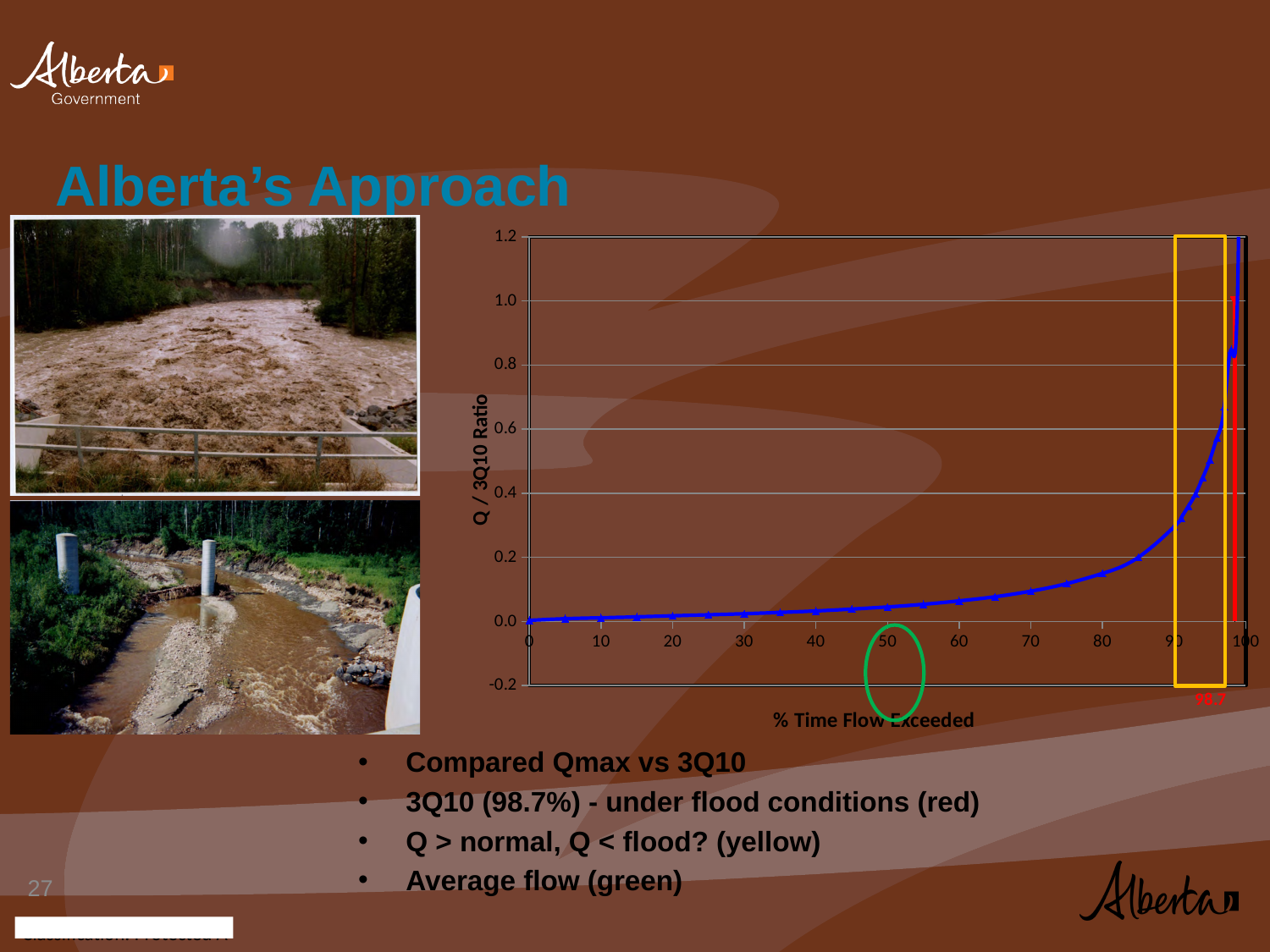
What kind of chart is shown on the slide? line chart What % Time Flow Exceeded value is printed in red below the x axis of the chart? 98.7 Which has the larger Q / 3Q10 Ratio: 50% Time Flow Exceeded or 90% Time Flow Exceeded? 90% Time Flow Exceeded Does the Q / 3Q10 Ratio rise or fall as % Time Flow Exceeded increases along the x axis? rise Is the Q / 3Q10 Ratio at 80% Time Flow Exceeded greater or less than 0.4? less Is the Q / 3Q10 Ratio at 20% Time Flow Exceeded greater or less than 0.2? less What is the title of the y axis of the chart? Q / 3Q10 Ratio How many tick labels are shown on the x axis of the chart? 11 Is the Q / 3Q10 Ratio at 90% Time Flow Exceeded greater or less than 0.2? greater What is the highest tick value shown on the y axis of the chart? 1.2 What is the title of the x axis of the chart? % Time Flow Exceeded